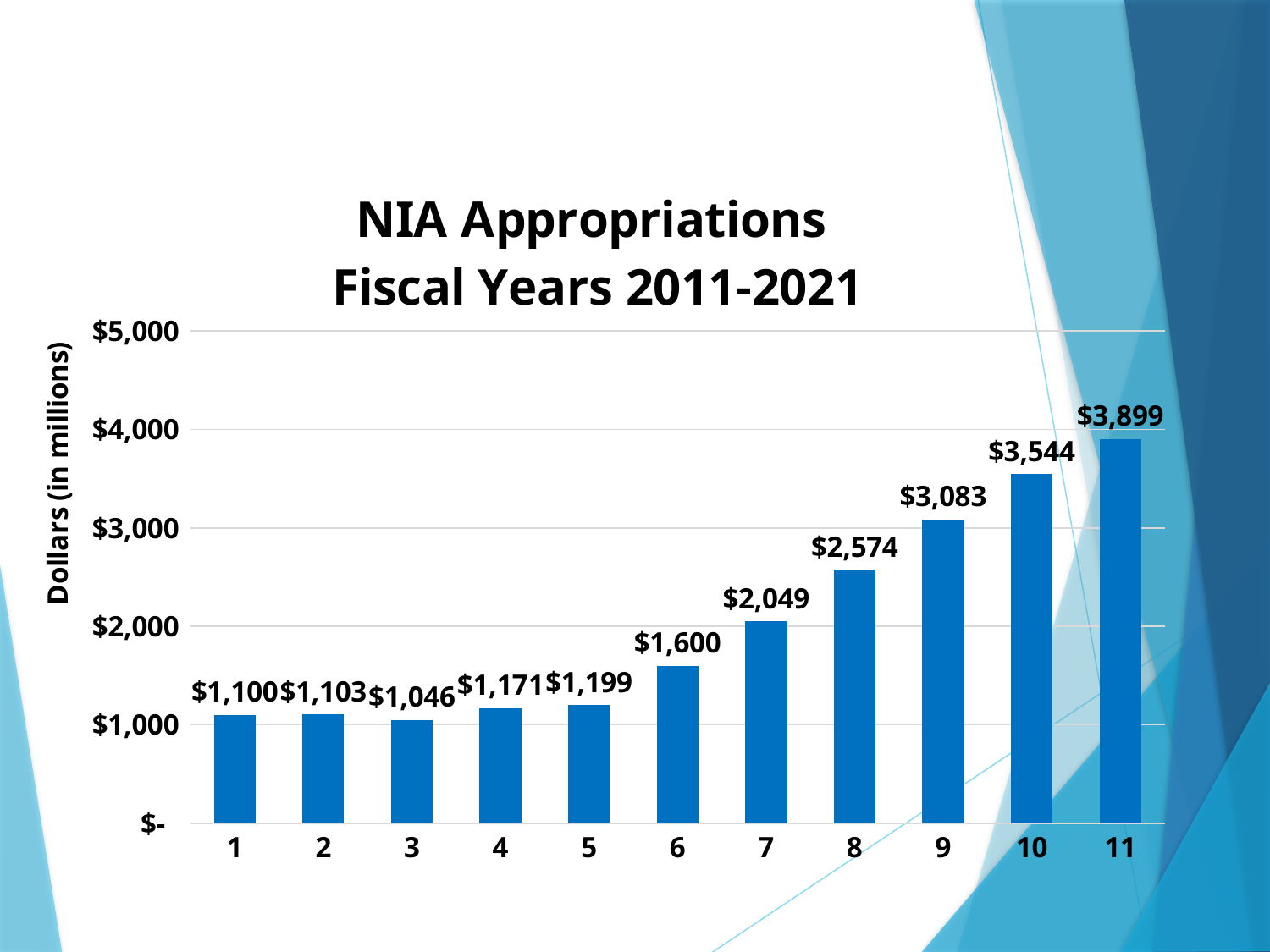
Do the values generally rise or fall from category 5 to category 11? rise What is the difference between the values for category 11 and category 10? $355 Which is larger, the value for category 4 or the value for category 5? 5 Which category has the highest value in the NIA Appropriations chart? 11 What is the label of the vertical axis of the chart? Dollars (in millions) What is the value for category 6 in the NIA Appropriations chart? $1,600 What kind of chart is shown on the slide? bar chart What is the difference between the values for category 8 and category 7? $525 Is the value for category 8 greater or less than $3,000? less What is the value for category 9 in the NIA Appropriations chart? $3,083 Which category has the lowest value in the NIA Appropriations chart? 3 How many categories are shown on the x axis of the chart? 11